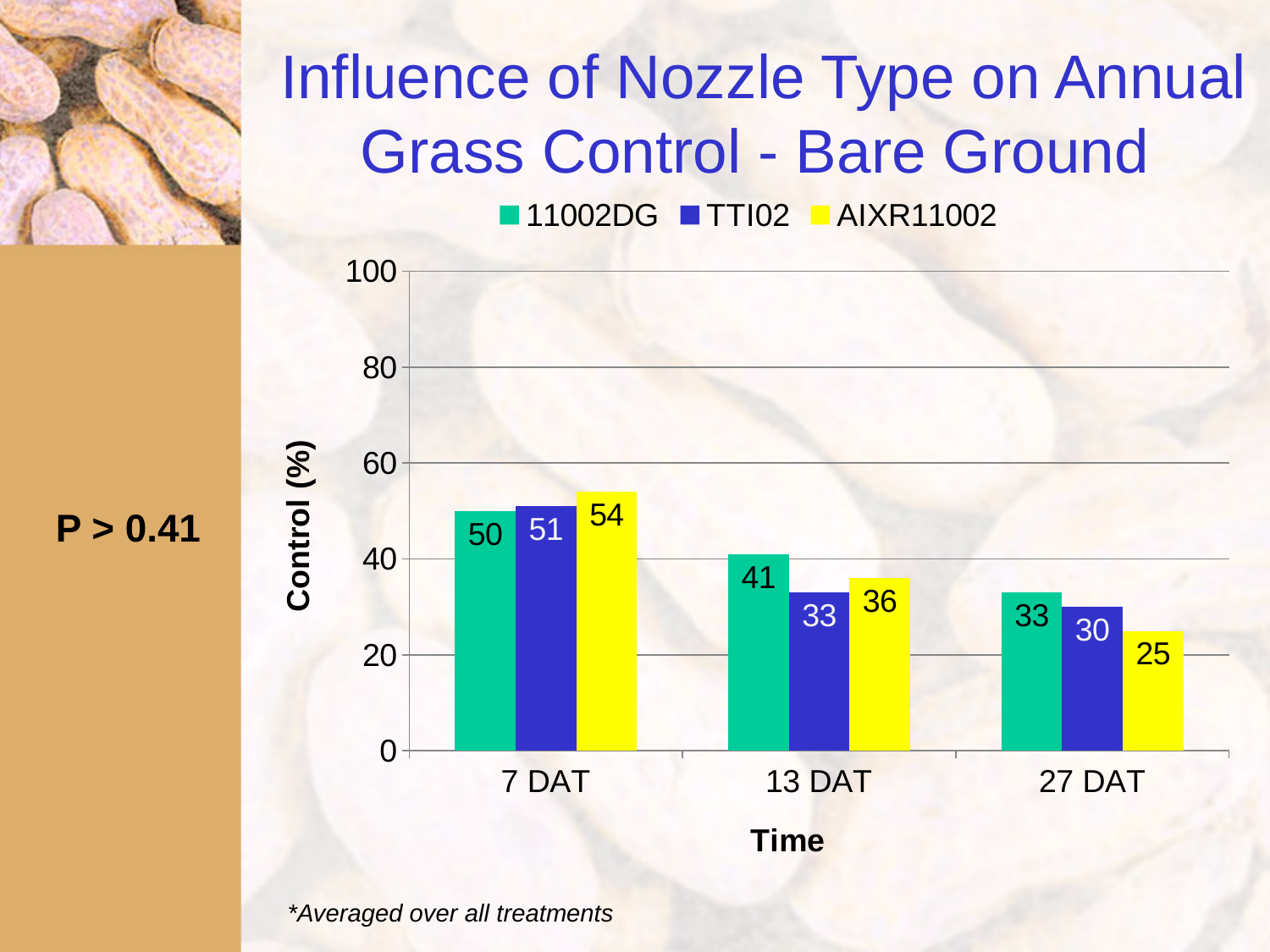
What is the control (%) for 11002DG at 7 DAT? 50 What is the control (%) for TTI02 at 13 DAT? 33 What is the control (%) for AIXR11002 at 27 DAT? 25 Which is larger at 13 DAT, the control for AIXR11002 or for TTI02? AIXR11002 What is the difference in control (%) between 11002DG and TTI02 at 13 DAT? 8 What kind of chart is shown on the slide? Bar chart How many time points are shown on the x axis? 3 Is the value for 11002DG at 13 DAT greater or less than 40? greater How many series does the legend list? 3 Which nozzle type has the lowest control at 27 DAT? AIXR11002 Does the control for 11002DG rise or fall from 7 DAT to 27 DAT? Fall Which nozzle type has the highest control at 7 DAT? AIXR11002